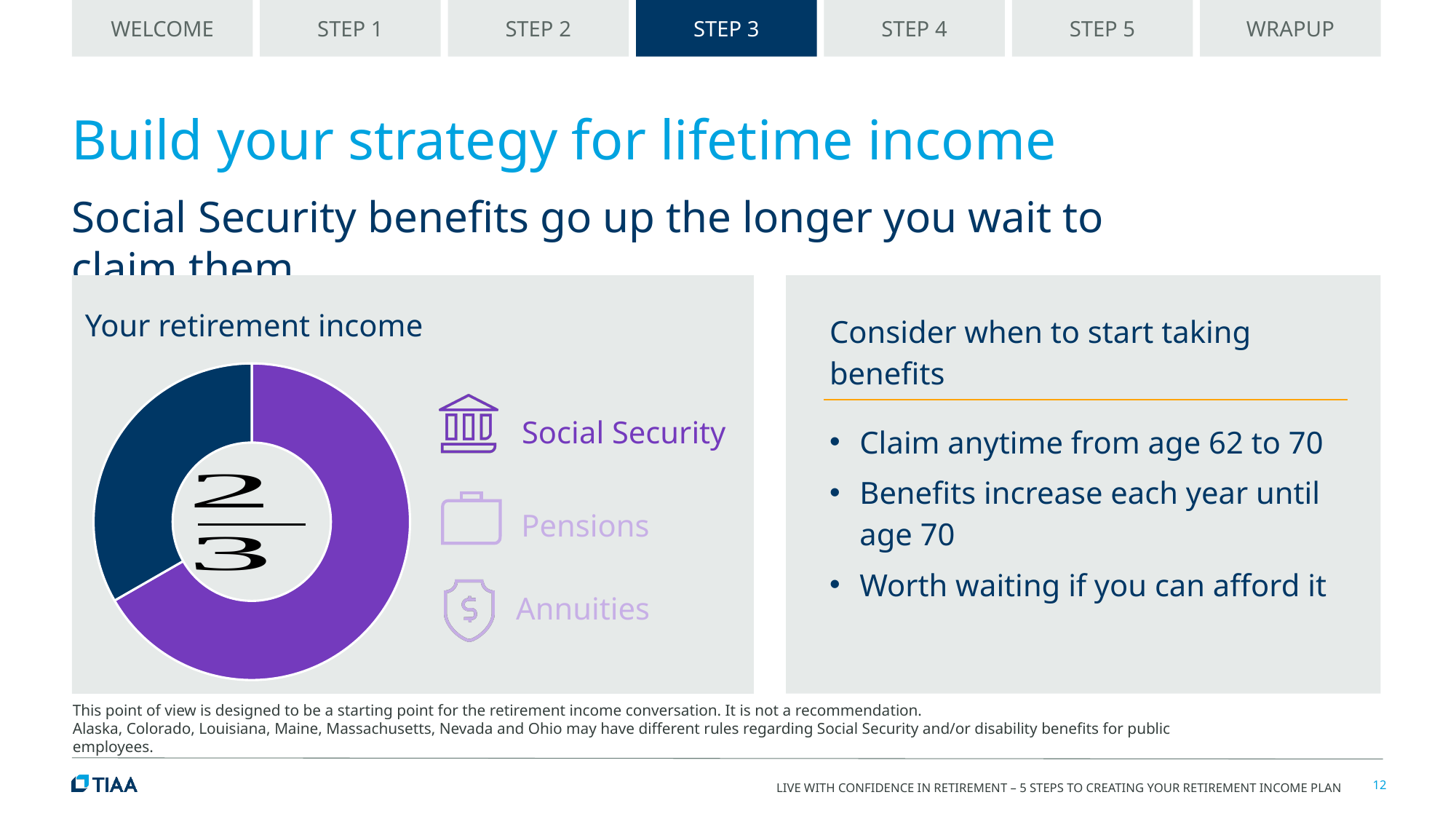
What kind of chart is shown under "Your retirement income"? Pie chart (donut) Is the purple slice of the donut chart greater or less than half of the chart? greater How many slices does the donut chart have? 2 Is the dark navy slice of the donut chart greater or less than half of the chart? less Which legend entry next to the donut chart is shown in the same purple colour as the large slice? Social Security How many income sources are listed in the legend next to the donut chart? 3 What is the title of the chart on the left side of the slide? Your retirement income Which slice of the donut chart is larger, the purple one or the dark navy one? The purple one Which category does the largest slice of the donut chart represent? Social Security What share of retirement income does the purple Social Security slice represent? 2/3 What fraction is printed in the center of the donut chart? 2/3